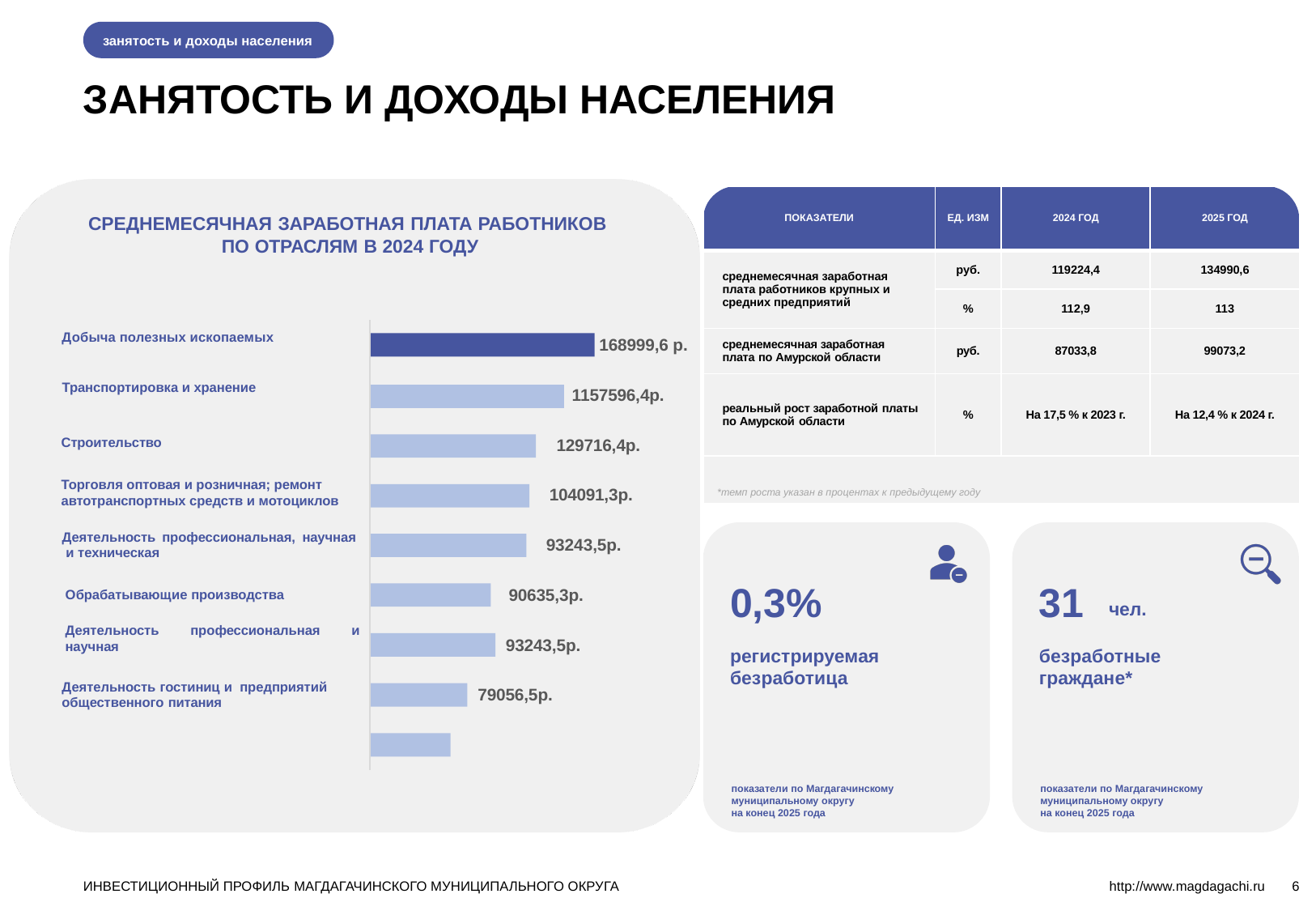
What type of chart is shown on the left of the slide? bar chart What is the value shown for Добыча полезных ископаемых? 168999,6 р. What is the title of the chart on the left of the slide? Среднемесячная заработная плата работников по отраслям в 2024 году What is the value shown for Обрабатывающие производства? 90635,3р. What is the value shown for Деятельность гостиниц и предприятий общественного питания? 79056,5р. What is the difference between the values for Строительство and Торговля оптовая и розничная; ремонт автотранспортных средств и мотоциклов? 25625,1 Which category has the longest bar in the chart? Добыча полезных ископаемых Which bar in the chart is drawn in a darker blue than the others? Добыча полезных ископаемых What is the value shown for Строительство? 129716,4р. Which labeled category has the lowest value in the chart? Деятельность гостиниц и предприятий общественного питания Which is larger: the value for Строительство or the value for Обрабатывающие производства? Строительство What is the value shown for Торговля оптовая и розничная; ремонт автотранспортных средств и мотоциклов? 104091,3р.